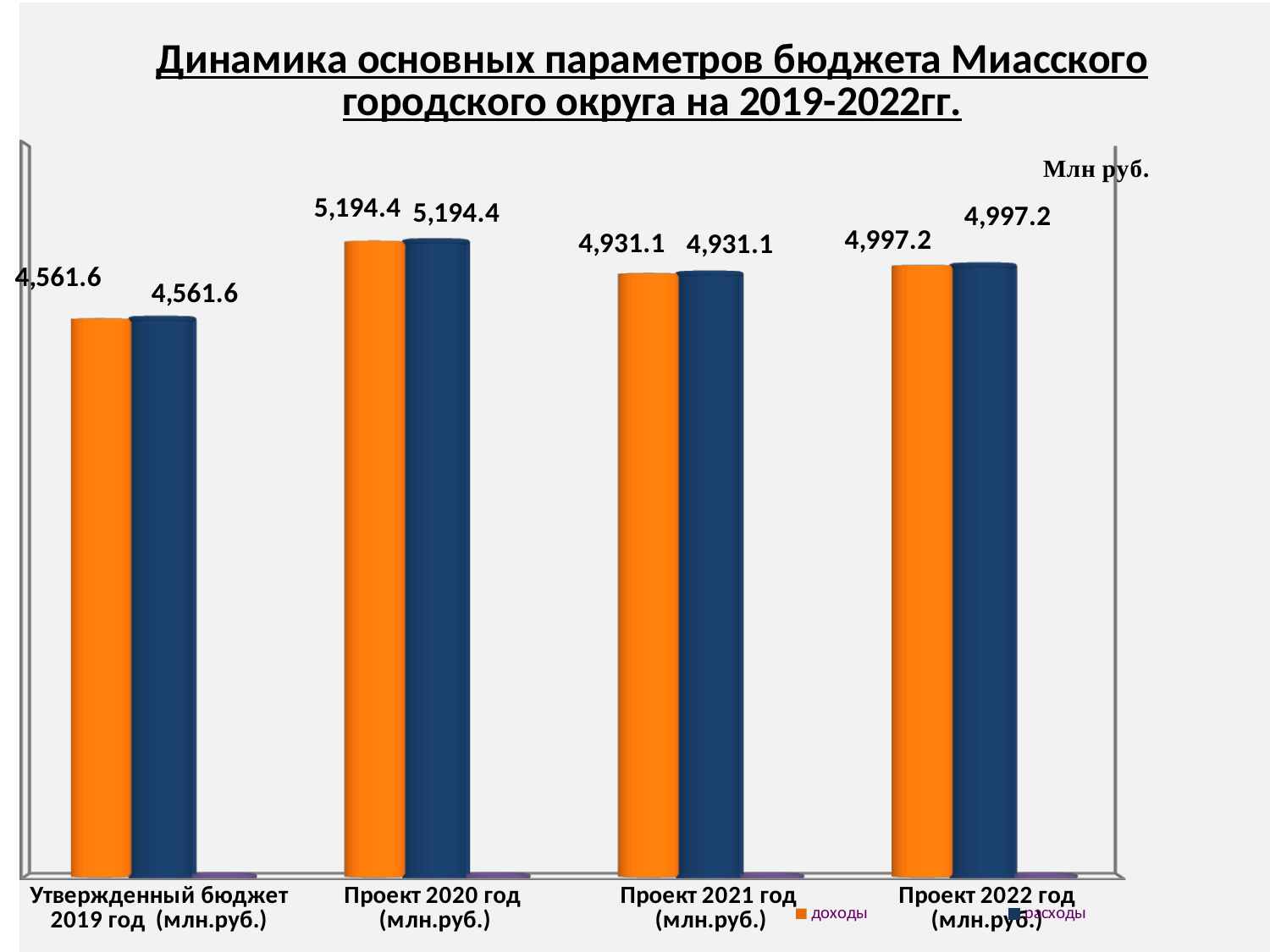
What is the value of расходы for Утвержденный бюджет 2019 год? 4,561.6 How many categories are shown on the x axis? 4 What is the value of расходы for Проект 2022 год? 4,997.2 What is the value of доходы for Проект 2021 год? 4,931.1 Which category has the highest value for доходы? Проект 2020 год What is the value of доходы for Проект 2020 год? 5,194.4 Which is larger: расходы for Проект 2021 год or расходы for Проект 2022 год? Проект 2022 год What is the difference between доходы for Проект 2020 год and доходы for Утвержденный бюджет 2019 год? 632.8 Which category has the lowest value for расходы? Утвержденный бюджет 2019 год What kind of chart is shown on the slide? bar chart Which colour represents the доходы series? orange How many series does the legend list? 2